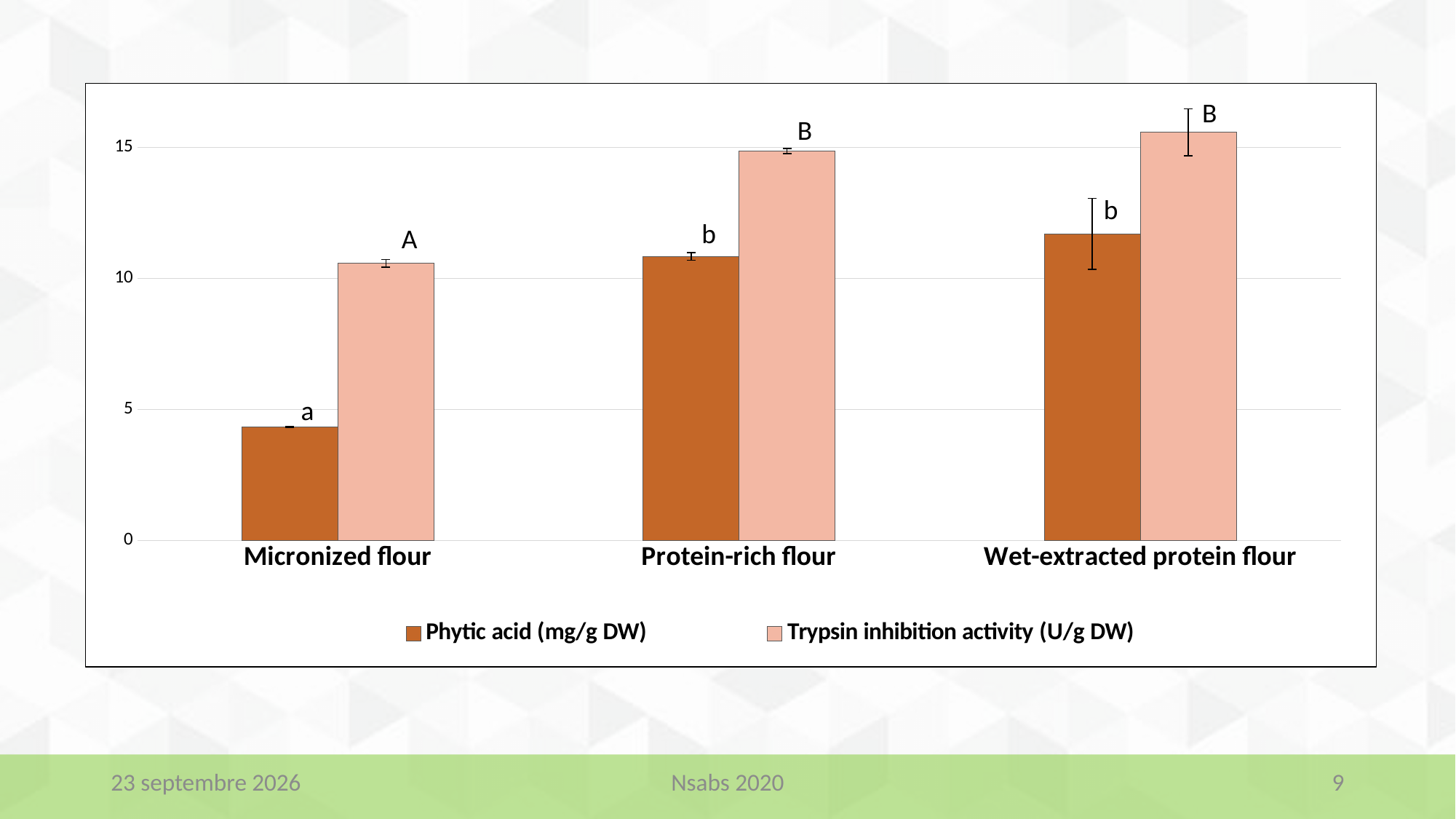
Is the Phytic acid (mg/g DW) value for Micronized flour greater or less than 5? less Do the Phytic acid (mg/g DW) values rise or fall from Micronized flour to Wet-extracted protein flour? rise Which category has the lowest Trypsin inhibition activity (U/g DW) value? Micronized flour How many flour categories are shown on the x axis? 3 For Micronized flour, which is larger: Phytic acid (mg/g DW) or Trypsin inhibition activity (U/g DW)? Trypsin inhibition activity (U/g DW) Which category has the highest Trypsin inhibition activity (U/g DW) value? Wet-extracted protein flour Is the Trypsin inhibition activity (U/g DW) value for Wet-extracted protein flour greater or less than 15? greater Which category has the lowest Phytic acid (mg/g DW) value? Micronized flour How many series does the legend list? 2 What kind of chart is shown on the slide? bar chart Which series is drawn in the darker orange-brown colour? Phytic acid (mg/g DW) Is the Trypsin inhibition activity (U/g DW) value for Micronized flour greater or less than 10? greater